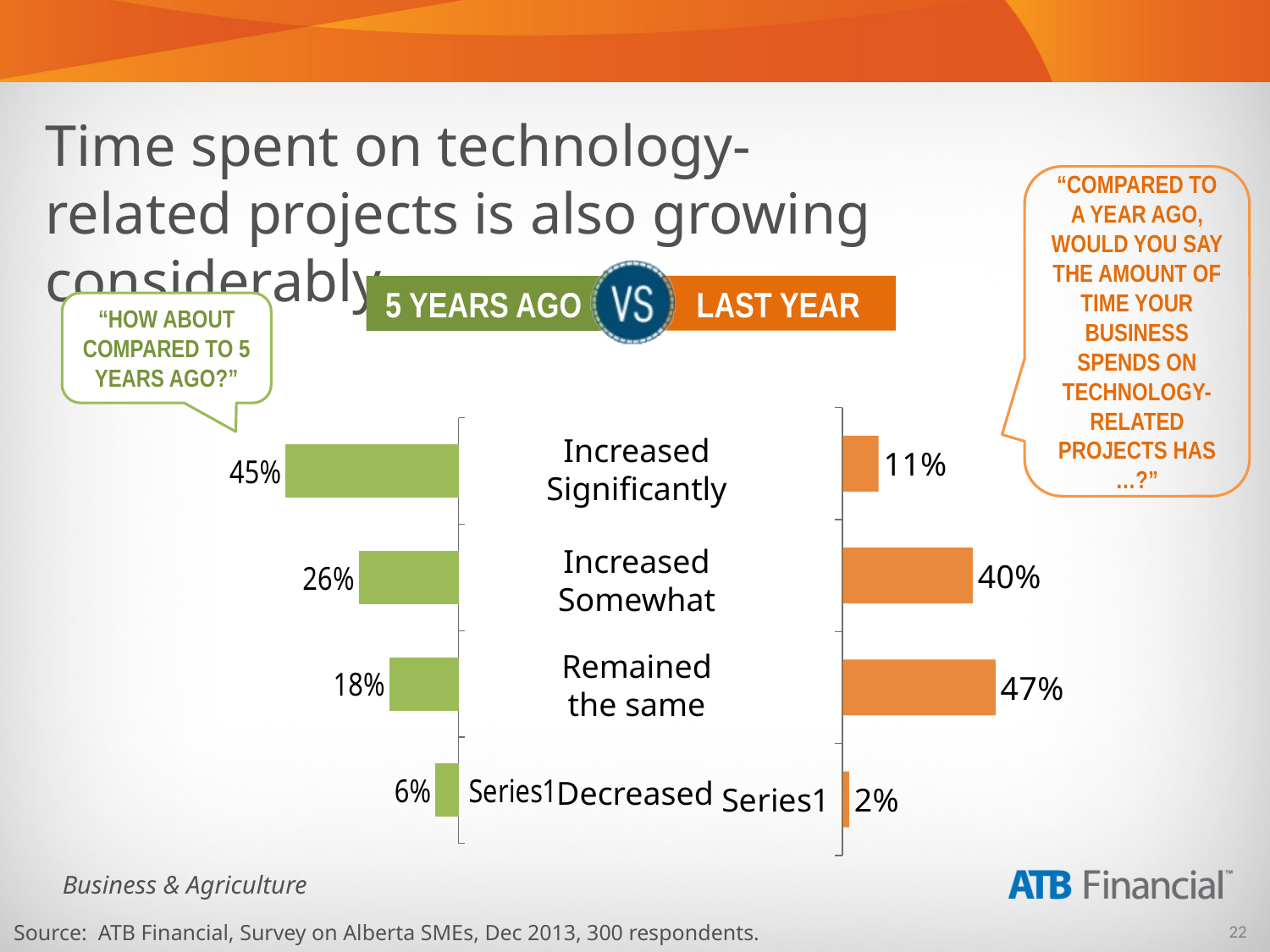
In the orange 'last year' chart on the right, what is the value for 'Increased Somewhat'? 40% In the orange 'last year' chart on the right, what is the value for 'Remained the same'? 47% What type of chart is the orange 'last year' chart on the right? Bar chart How many categories are shown in the green '5 years ago' chart on the left? 4 In the green '5 years ago' chart on the left, what is the difference between 'Increased Somewhat' and 'Remained the same'? 8% In the orange 'last year' chart on the right, which category has the highest value? Remained the same What colour are the bars in the 'last year' chart on the right? Orange What is the difference between the 'Increased Significantly' value in the green '5 years ago' chart and the same category in the orange 'last year' chart? 34% In the green '5 years ago' chart on the left, what is the value for 'Increased Significantly'? 45% In the green '5 years ago' chart on the left, which category has the highest value? Increased Significantly Which is larger: 'Remained the same' in the green '5 years ago' chart or 'Remained the same' in the orange 'last year' chart? Last year (47%) In the orange 'last year' chart on the right, which category has the lowest value? Decreased